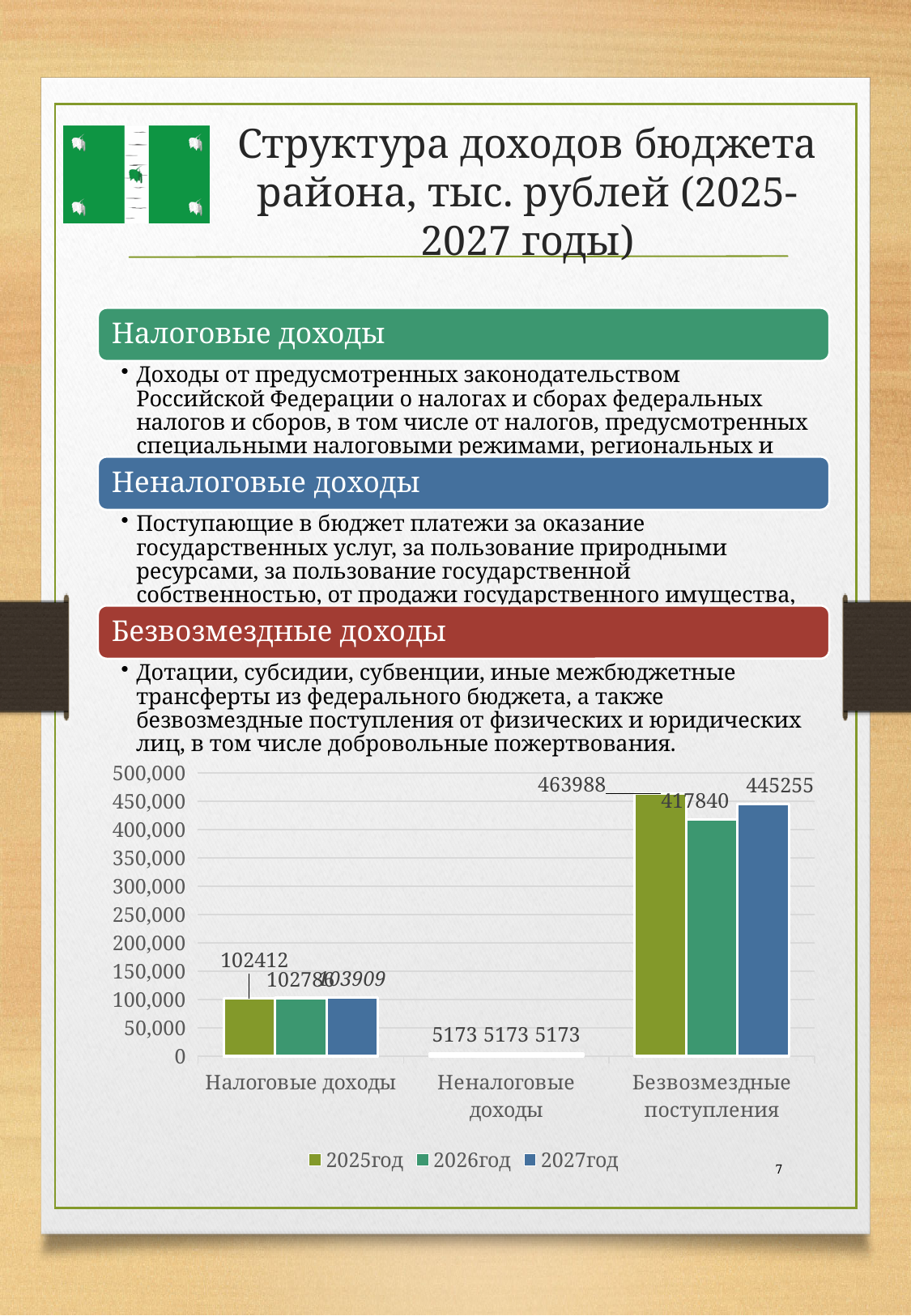
Which category has the lowest values across all three series? Неналоговые доходы Which is larger for Безвозмездные поступления: the 2025год value or the 2027год value? 2025год How many series does the legend list? 3 What is the value for Налоговые доходы in the 2025год series? 102412 Is the value for Налоговые доходы in 2027год greater or less than 150,000? less What is the value for Безвозмездные поступления in the 2025год series? 463988 What is the value for Неналоговые доходы in the 2026год series? 5173 What is the difference between the 2025год and 2026год values for Безвозмездные поступления? 46148 What is the value for Безвозмездные поступления in the 2027год series? 445255 What kind of chart is shown on the slide? bar chart Which category has the highest value in the 2025год series? Безвозмездные поступления What is the value for Безвозмездные поступления in the 2026год series? 417840